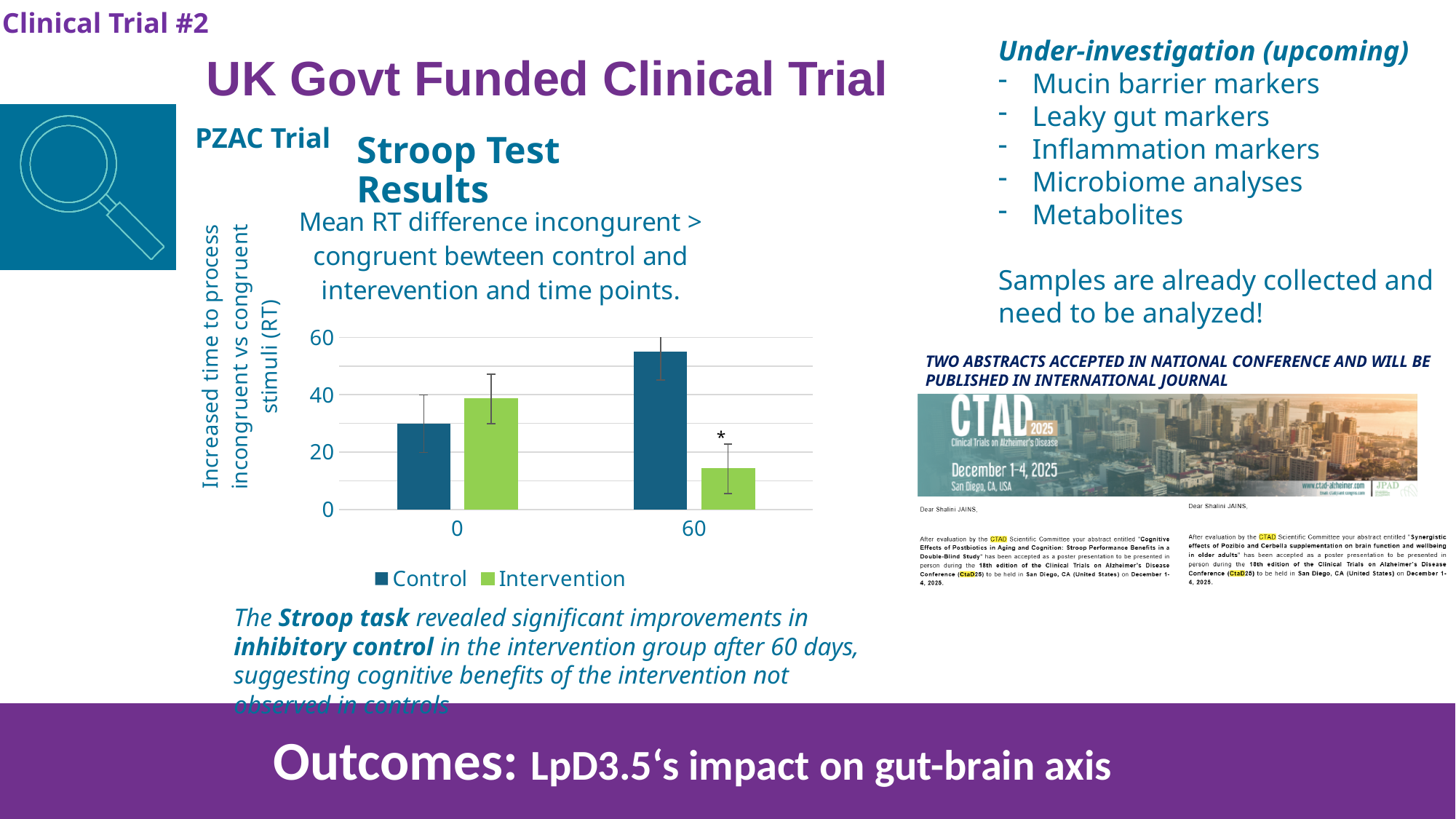
What kind of chart is shown under the title "Stroop Test Results"? bar chart In the Stroop Test Results chart, is the Control value at time point 60 greater or less than 40? greater Does the Control series in the Stroop Test Results chart rise or fall from time point 0 to 60? rise At time point 60 in the Stroop Test Results chart, which is larger, Control or Intervention? Control In the Stroop Test Results chart, is the Control value at time point 0 greater or less than 40? less Which bar in the Stroop Test Results chart is the shortest? Intervention at 60 In the Stroop Test Results chart, is the Intervention value at time point 60 greater or less than 20? less Which bar in the Stroop Test Results chart is the tallest? Control at 60 Which series in the Stroop Test Results chart is shown in green? Intervention How many series does the legend of the Stroop Test Results chart list? 2 Does the Intervention series in the Stroop Test Results chart rise or fall from time point 0 to 60? fall How many time-point categories are shown on the x axis of the Stroop Test Results chart? 2